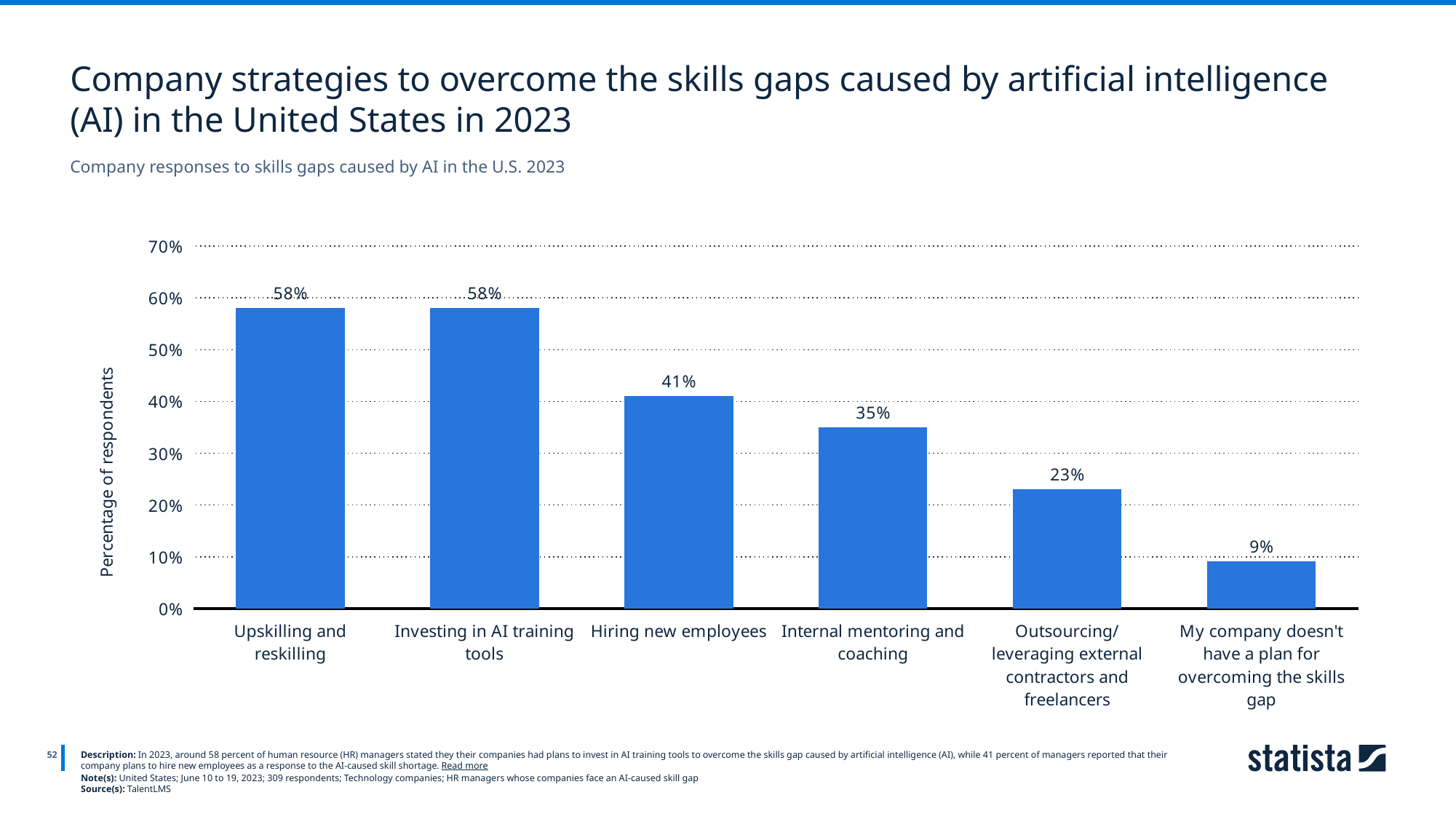
What is the label of the y axis? Percentage of respondents Is the value for 'Internal mentoring and coaching' greater or less than 40%? less Which category has the lowest value? My company doesn't have a plan for overcoming the skills gap What percentage of respondents said their company doesn't have a plan for overcoming the skills gap? 9% How many categories are shown on the chart? 6 What is the difference between 'Hiring new employees' and 'Internal mentoring and coaching'? 6% What percentage of respondents chose 'Hiring new employees' as a strategy? 41% What is the difference between 'Upskilling and reskilling' and 'Outsourcing/leveraging external contractors and freelancers'? 35% What kind of chart is shown on the slide? Bar chart What is the value for 'Internal mentoring and coaching'? 35% What is the value for 'Outsourcing/leveraging external contractors and freelancers'? 23% Which is larger, the value for 'Hiring new employees' or for 'Outsourcing/leveraging external contractors and freelancers'? Hiring new employees